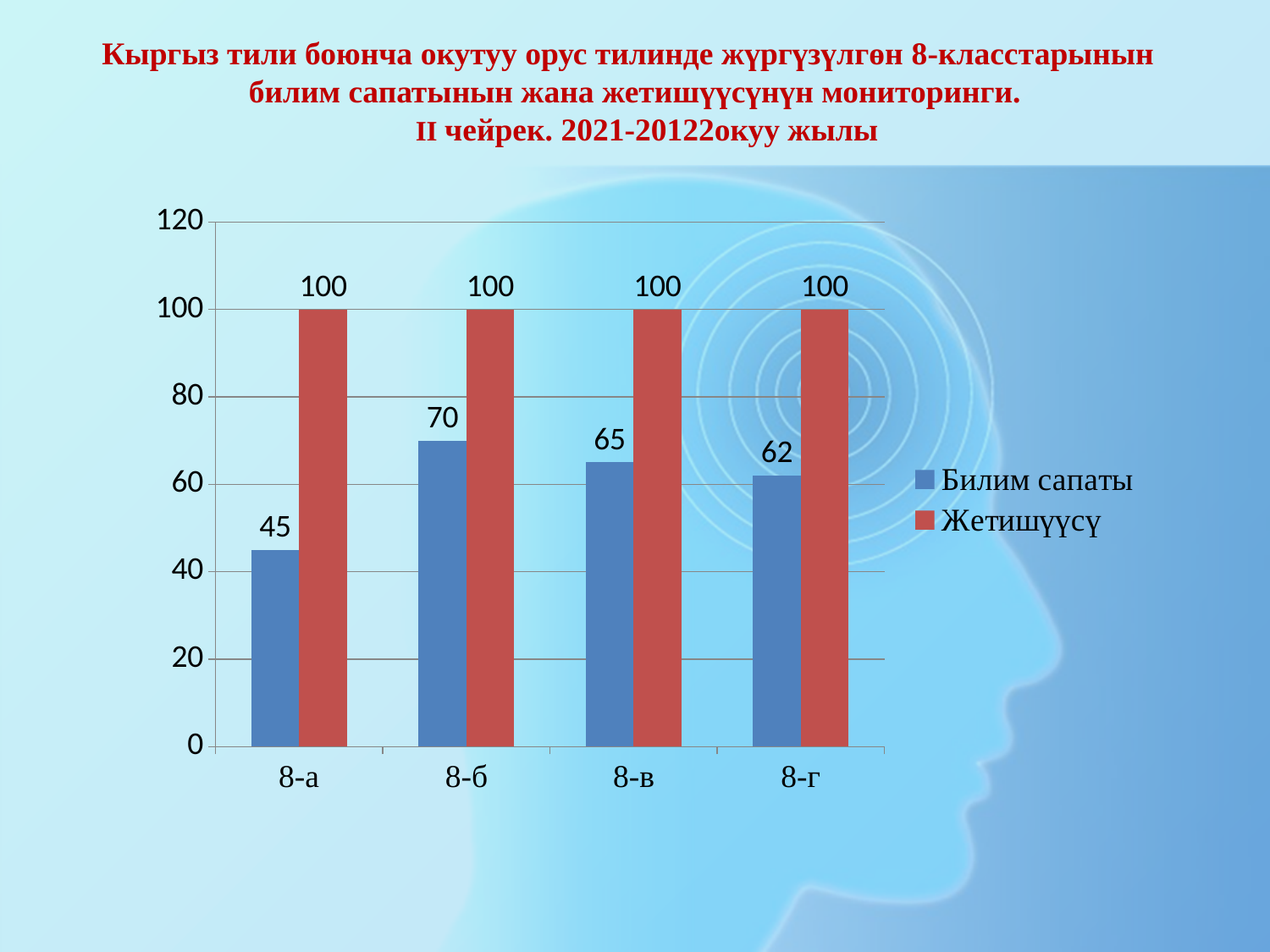
What is the value of Жетишүүсү for 8-в? 100 What is the value of Билим сапаты for 8-г? 62 What kind of chart is shown on the slide? bar chart How many classes are shown on the x axis? 4 What is the value of Билим сапаты for 8-б? 70 Which is larger, the Билим сапаты value for 8-в or for 8-г? 8-в How many series does the legend list? 2 What is the value of Билим сапаты for 8-а? 45 Which class has the lowest Билим сапаты value? 8-а What is the difference between the Билим сапаты values for 8-б and 8-а? 25 Which colour represents the Жетишүүсү series? red Which class has the highest Билим сапаты value? 8-б